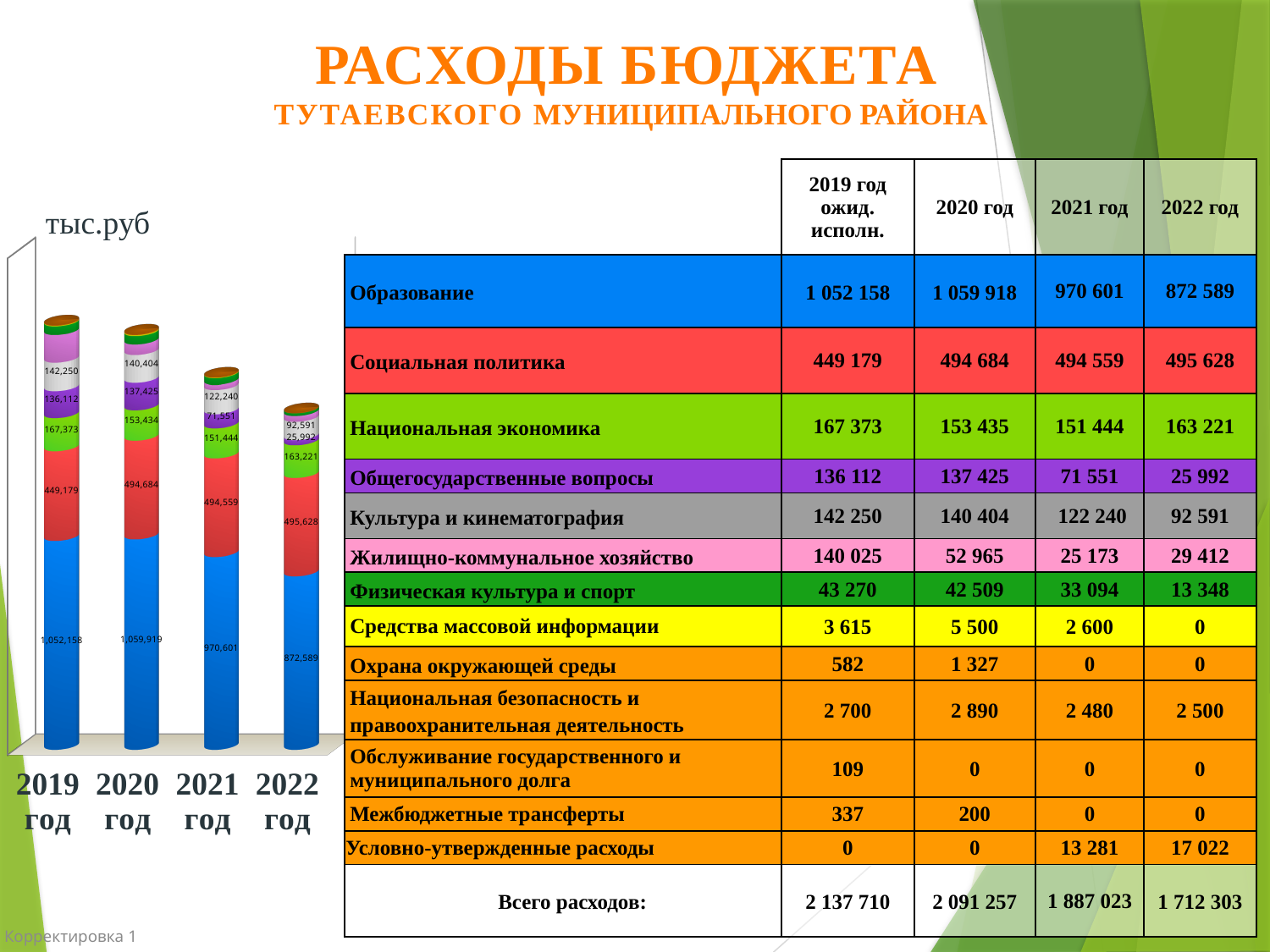
Is the blue segment larger for 2020 год or for 2022 год? 2020 год Which year has the tallest bar in the chart? 2019 год What is the value of the purple segment of the 2020 год bar? 137,425 How many bars (years) does the chart show? 4 What is the value of the blue (bottom) segment of the 2019 год bar? 1,052,158 What is the difference between the blue segment values for 2019 год and 2021 год? 81,557 Which year has the shortest bar in the chart? 2022 год Do the total bar heights rise or fall from 2019 год to 2022 год? fall What is the value of the red segment of the 2022 год bar? 495,628 What kind of chart is shown on the left of the slide? stacked bar chart What unit label is shown above the chart? тыс.руб What is the value of the green segment of the 2021 год bar? 151,444